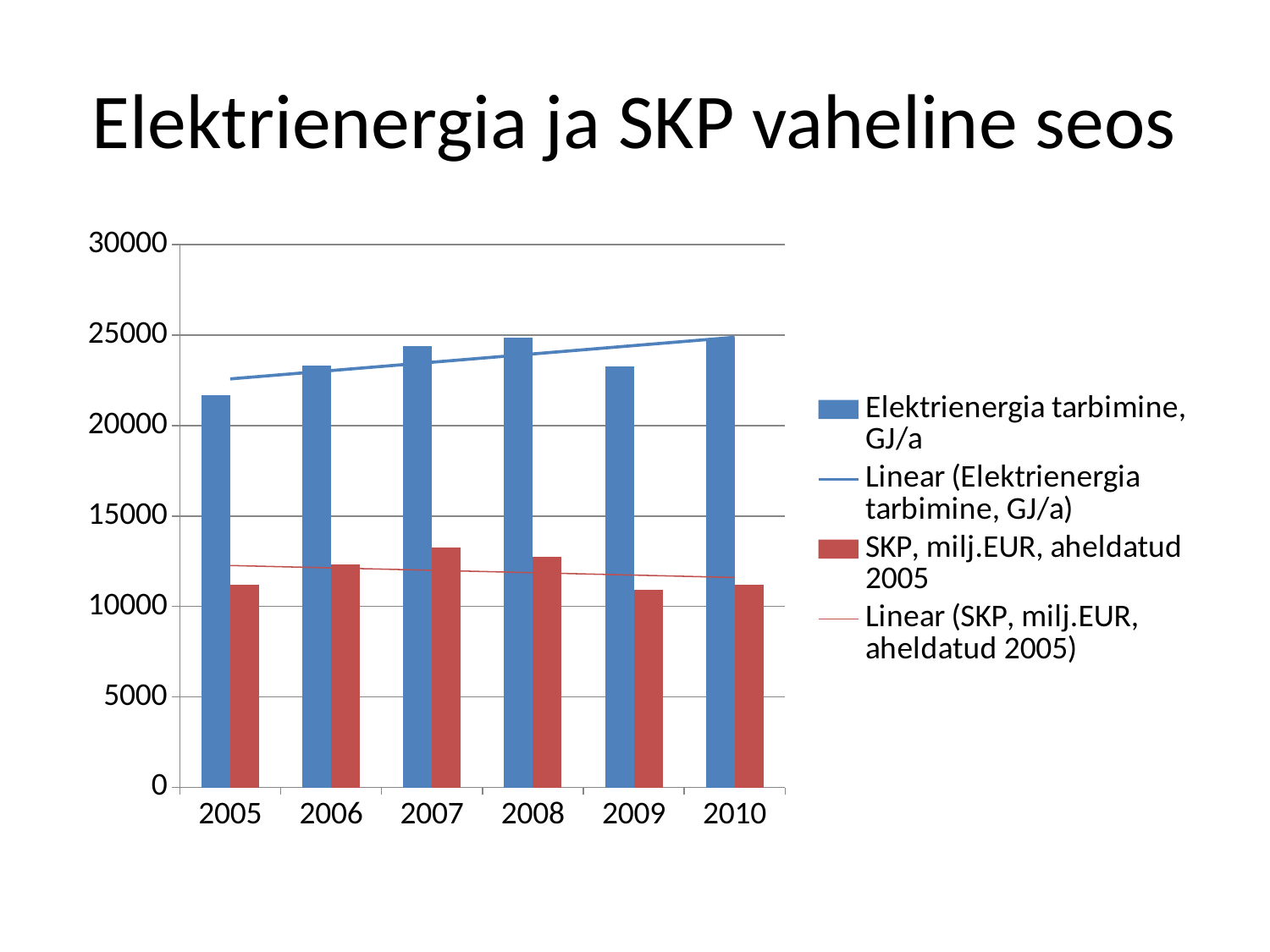
What kind of chart is shown on the slide? bar chart In which year is the 'Elektrienergia tarbimine, GJ/a' bar the lowest? 2005 What is the title of the slide containing the chart? Elektrienergia ja SKP vaheline seos Is the value for 'SKP, milj.EUR, aheldatud 2005' in 2009 greater or less than 10000? greater Does the linear trendline for 'Elektrienergia tarbimine, GJ/a' rise or fall from 2005 to 2010? rise Is the value for 'Elektrienergia tarbimine, GJ/a' in 2005 greater or less than 20000? greater Which colour represents the series 'SKP, milj.EUR, aheldatud 2005'? red Is the value for 'SKP, milj.EUR, aheldatud 2005' in 2007 greater or less than 15000? less How many years are shown on the x axis of the chart? 6 Which is larger: 'Elektrienergia tarbimine, GJ/a' in 2007 or in 2005? 2007 In which year is the 'SKP, milj.EUR, aheldatud 2005' bar the highest? 2007 How many entries does the chart's legend list? 4